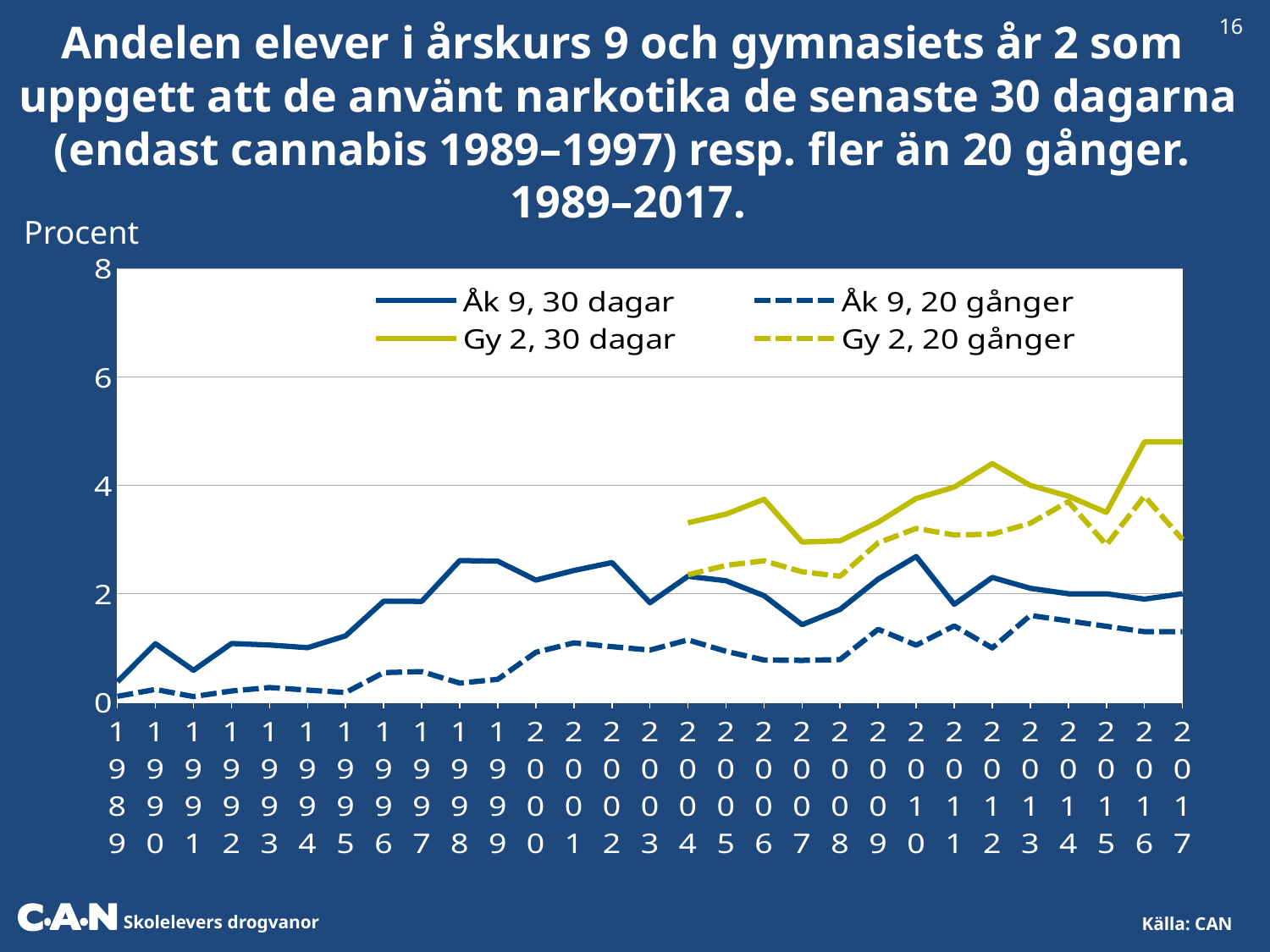
Is the value for Gy 2, 20 gånger in 2017 greater or less than 2? greater How many series does the legend list? 4 How many years are plotted along the x axis? 29 In 2017, which is larger: Gy 2, 30 dagar or Åk 9, 30 dagar? Gy 2, 30 dagar What is the label on the y axis? Procent Is the value for Åk 9, 20 gånger in 2017 greater or less than 2? less Is the value for Gy 2, 30 dagar in 2017 greater or less than 4? greater Which series has the highest value in 2017? Gy 2, 30 dagar For Åk 9, 30 dagar, which is larger: the value in 1989 or the value in 2004? 2004 Does the Åk 9, 30 dagar line rise or fall from 1989 to 1997? Rises What kind of chart is shown on the slide? Line chart